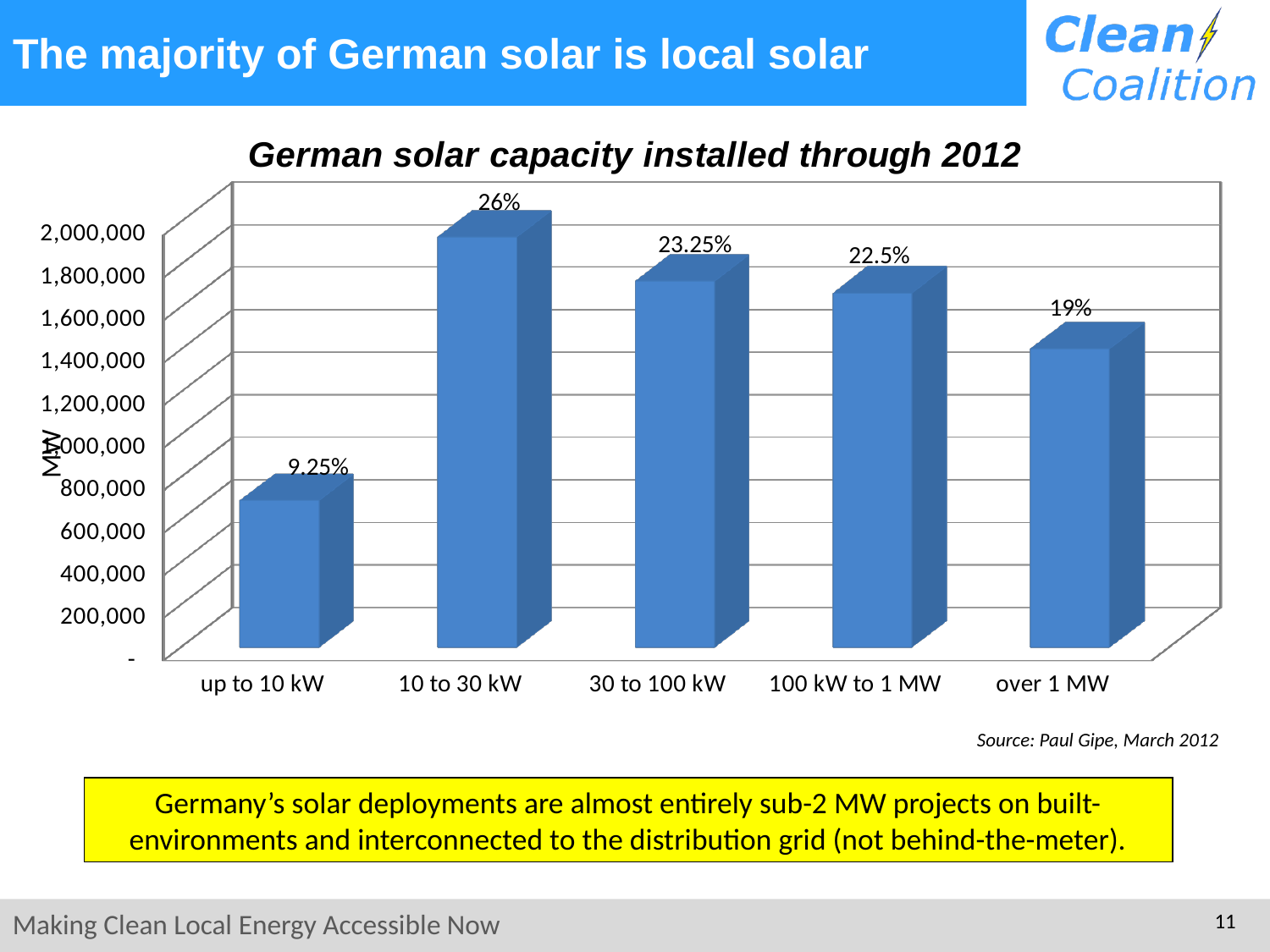
What is the difference in percentage points between the labels for '10 to 30 kW' and 'up to 10 kW'? 16.75% What kind of chart is shown on the slide? Bar chart What percentage label is shown on the bar for '10 to 30 kW'? 26% Which size category has the lowest installed capacity? up to 10 kW Which size category has the highest installed capacity? 10 to 30 kW Which has the larger share, '30 to 100 kW' or '100 kW to 1 MW'? 30 to 100 kW What percentage label is shown on the bar for 'over 1 MW'? 19% How many size categories are shown on the x axis? 5 Is the value in MW for 'over 1 MW' greater or less than 1,600,000? less What percentage label is shown on the bar for '100 kW to 1 MW'? 22.5% What percentage label is shown on the bar for 'up to 10 kW'? 9.25% Is the value in MW for 'up to 10 kW' greater or less than 1,000,000? less